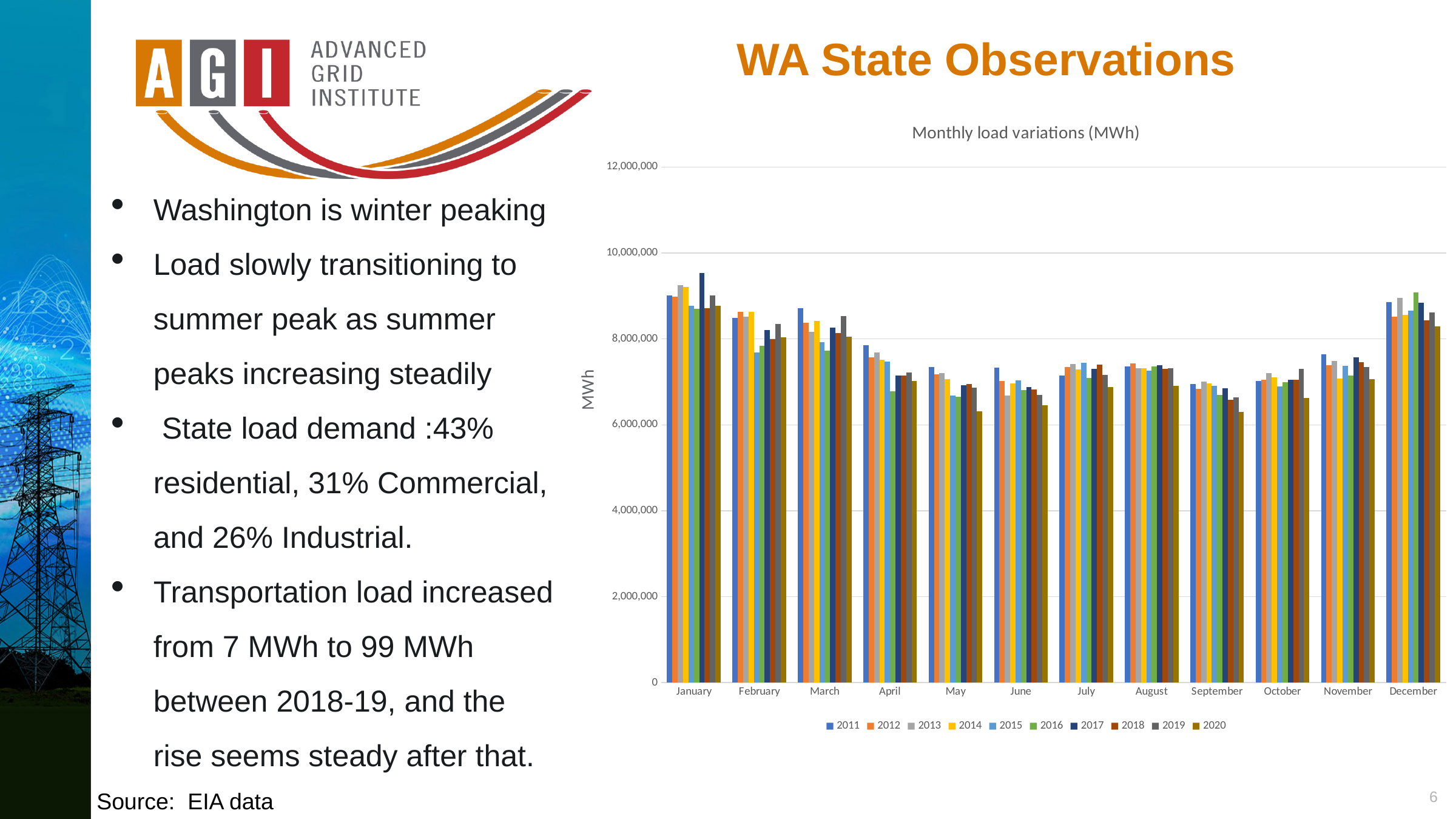
What type of chart is shown on the slide? Bar chart How many months (categories) are shown on the x axis of the chart? 12 What is the title of the chart? Monthly load variations (MWh) Is the value for 2016 in April greater or less than 8,000,000? less How many series (years) does the chart legend list? 10 What is the label on the vertical axis of the chart? MWh For 2011, is the value in January larger or the value in May? January Which year has the lowest bar in May? 2020 Which year has the tallest bar in January? 2017 Is the value for 2020 in May greater or less than 8,000,000? less Is the value for 2011 in June greater or less than 6,000,000? greater